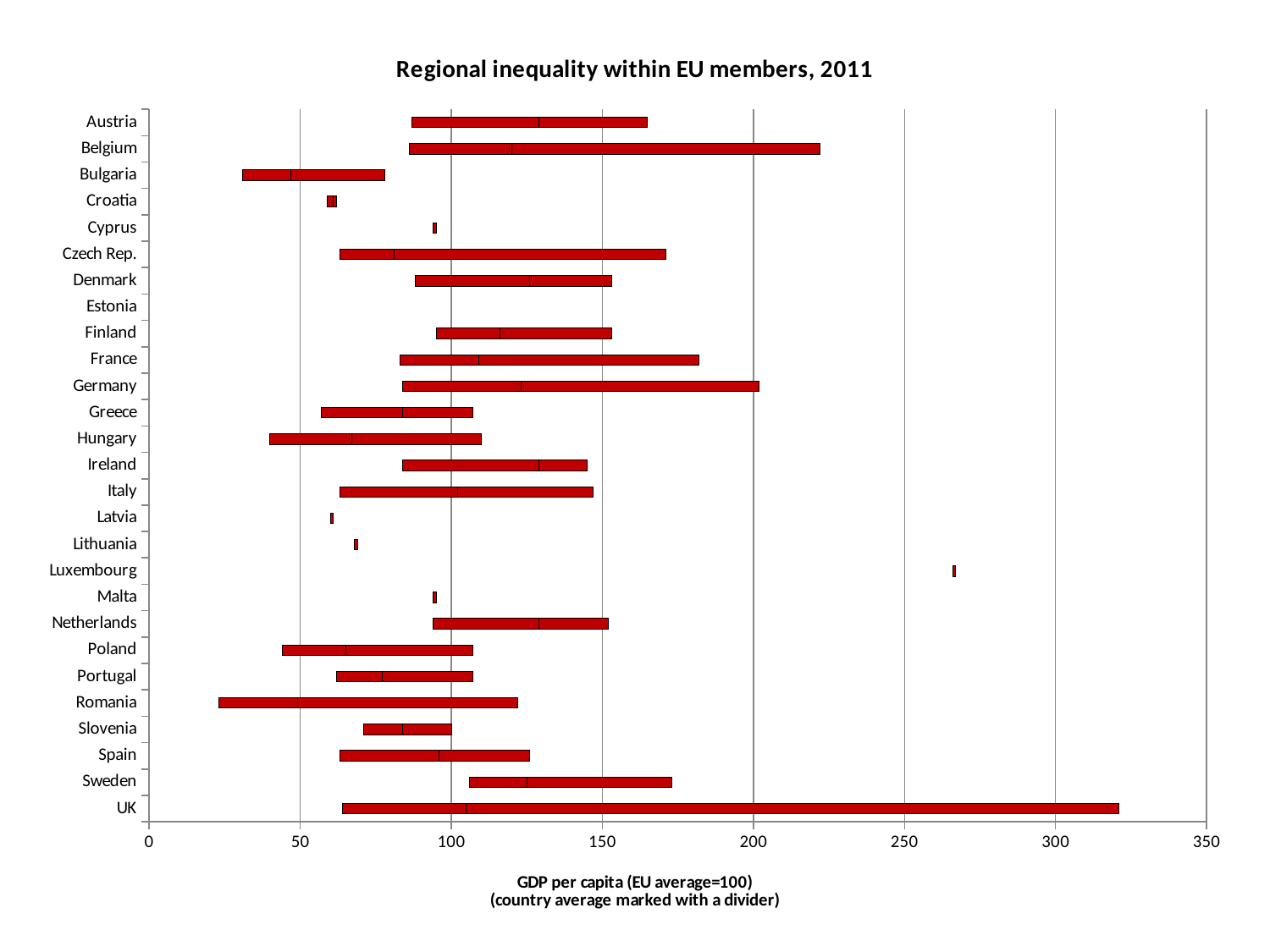
Which country has a wider range between its lowest and highest regions, Belgium or Austria? Belgium Is the upper end of Bulgaria's bar greater or less than 100? less How many countries are listed on the vertical axis of the chart? 27 Is the upper end of Belgium's bar greater or less than 200? greater Is the upper end of Luxembourg's bar greater or less than 250? greater Which country's bar extends to the highest GDP per capita value? UK What kind of chart is shown on the slide? Bar chart Which country's bar starts at the lowest GDP per capita value? Romania Which country's bar reaches a higher upper value, Germany or France? Germany What is the label of the horizontal axis? GDP per capita (EU average=100) (country average marked with a divider) What is the title of the chart? Regional inequality within EU members, 2011